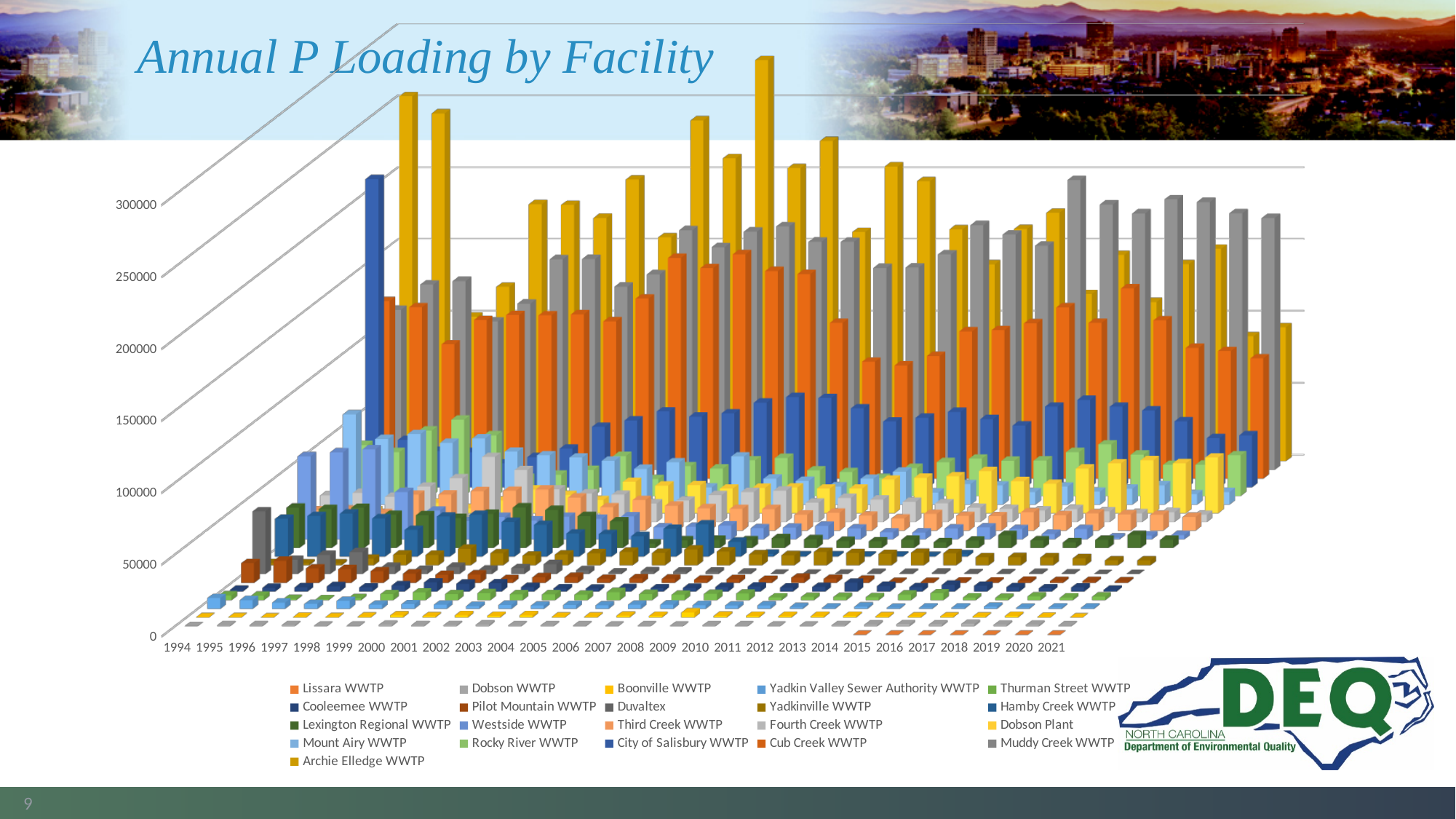
What is the highest value labelled on the vertical axis? 300000 What is the title of the chart? Annual P Loading by Facility What is the first year shown on the x axis? 1994 What is the last year shown on the x axis? 2021 Which facility is listed last in the legend? Archie Elledge WWTP How many years are shown along the x axis? 28 How many facilities (series) does the legend list? 21 What type of chart is shown on the slide? bar chart